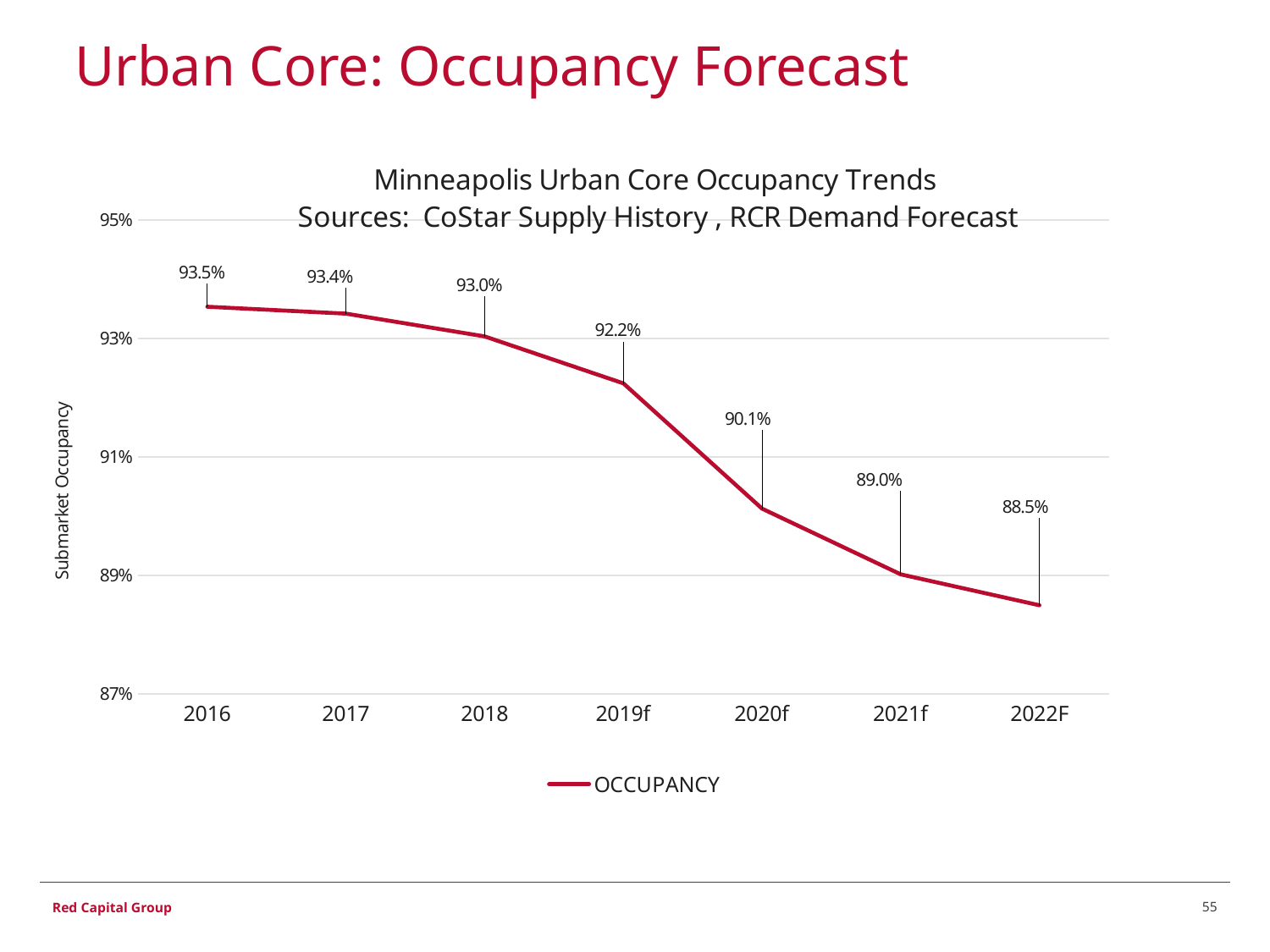
How many years are plotted on the x axis? 7 Do the occupancy values rise or fall from 2016 to 2022F? fall Is the occupancy value for 2020f greater or less than 91%? less Which year has the lowest occupancy? 2022F What is the difference between the occupancy in 2016 and in 2022F? 5.0% Which is larger, the occupancy in 2018 or in 2021f? 2018 What is the occupancy value for 2016? 93.5% What kind of chart is shown? line chart What is the difference between the occupancy in 2019f and in 2020f? 2.1% Which year has the highest occupancy? 2016 What is the occupancy value for 2022F? 88.5% What is the occupancy value for 2019f? 92.2%